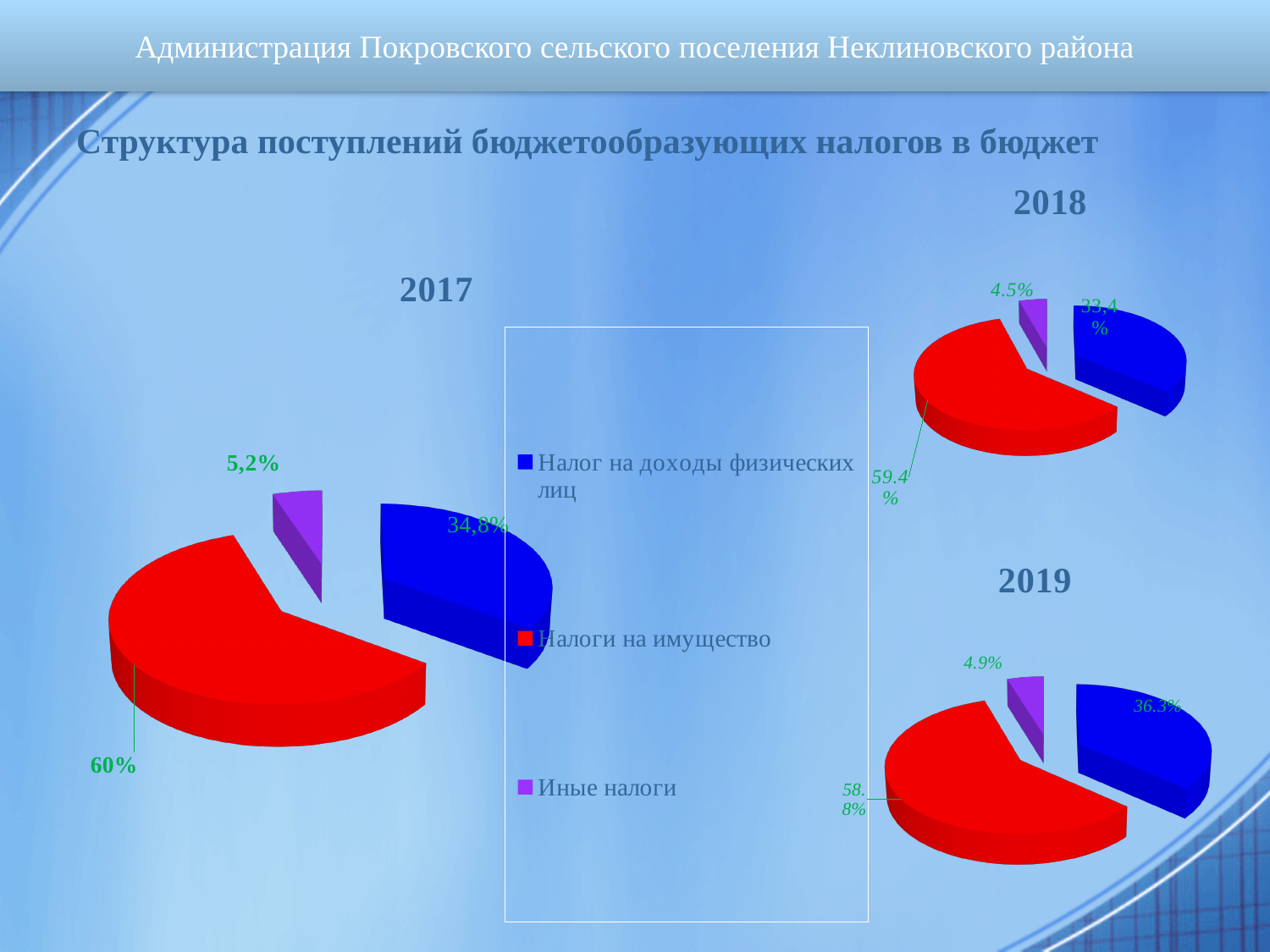
In the 2017 pie chart, what is the difference between the shares for Налоги на имущество and Налог на доходы физических лиц? 25,2% In the 2017 pie chart, what is the share for Иные налоги? 5,2% In the 2017 pie chart, what is the share for Налог на доходы физических лиц? 34,8% In the 2018 pie chart, what is the share for Иные налоги? 4.5% In the 2019 pie chart, what is the share for Налоги на имущество? 58.8% In the 2019 pie chart, which category has the smallest share? Иные налоги In the 2017 pie chart, what is the share for Налоги на имущество? 60% In the 2018 pie chart, which category has the largest share? Налоги на имущество In the 2019 pie chart, what is the share for Налог на доходы физических лиц? 36.3% In the 2018 pie chart, what is the share for Налоги на имущество? 59.4% What type of chart is used for the 2017, 2018 and 2019 data? Pie chart How many entries does the legend list? 3